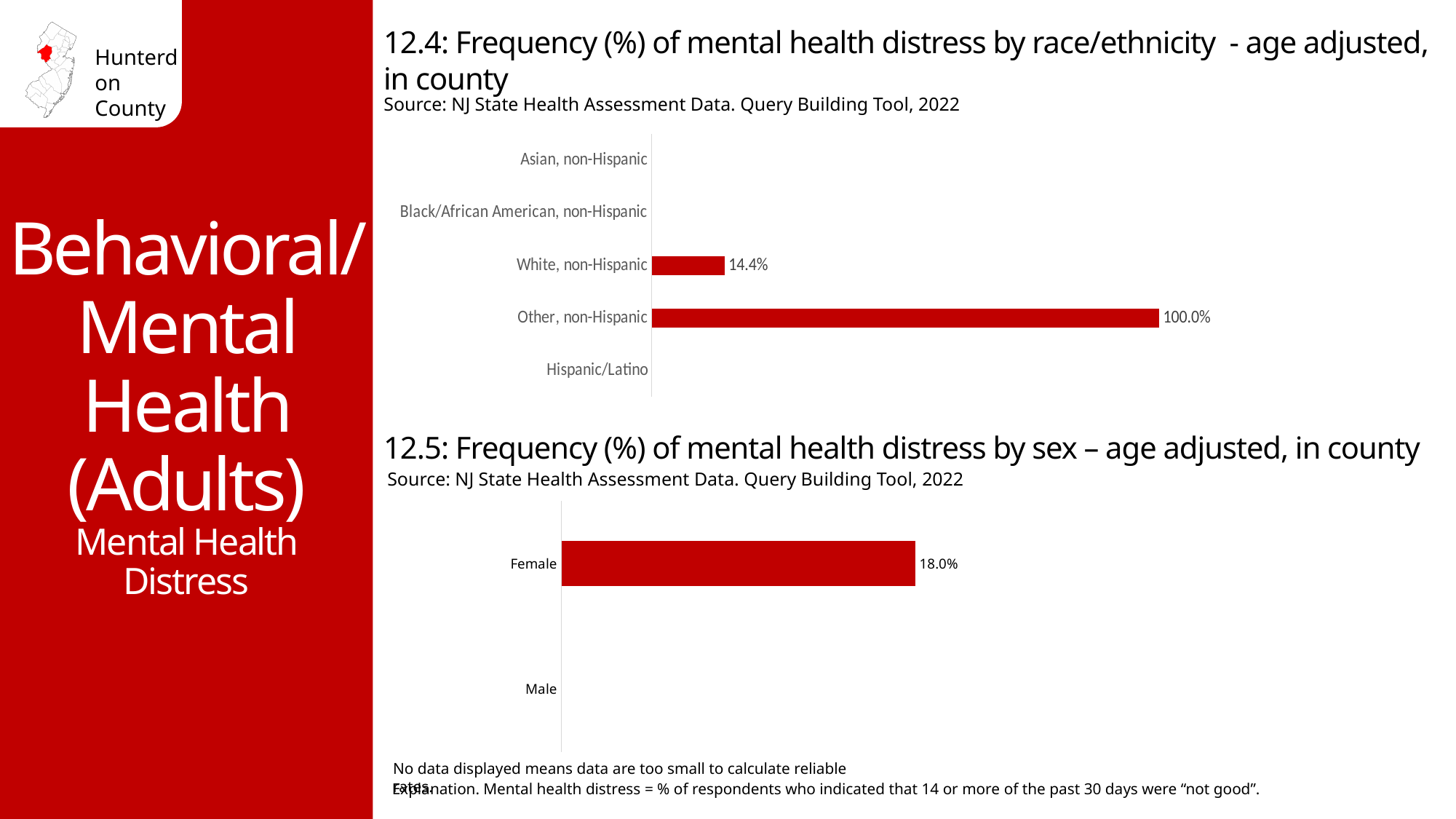
What is the source cited for chart 12.5 (mental health distress by sex)? NJ State Health Assessment Data. Query Building Tool, 2022 In chart 12.5 (mental health distress by sex), which category has a bar displayed? Female In chart 12.4 (mental health distress by race/ethnicity), how many categories have a bar displayed? 2 In chart 12.4 (mental health distress by race/ethnicity), what is the difference between the values for Other, non-Hispanic and White, non-Hispanic? 85.6% What kind of chart is chart 12.4 (mental health distress by race/ethnicity)? Bar chart In chart 12.5 (mental health distress by sex), what is the value for Female? 18.0% How many race/ethnicity categories are listed on the axis of chart 12.4? 5 How many categories are listed on the axis of chart 12.5 (mental health distress by sex)? 2 In chart 12.4 (mental health distress by race/ethnicity), which category has the highest value? Other, non-Hispanic In chart 12.4 (mental health distress by race/ethnicity), what is the value for White, non-Hispanic? 14.4% In chart 12.4 (mental health distress by race/ethnicity), which is larger: the value for White, non-Hispanic or Other, non-Hispanic? Other, non-Hispanic In chart 12.4 (mental health distress by race/ethnicity), what is the value for Other, non-Hispanic? 100.0%